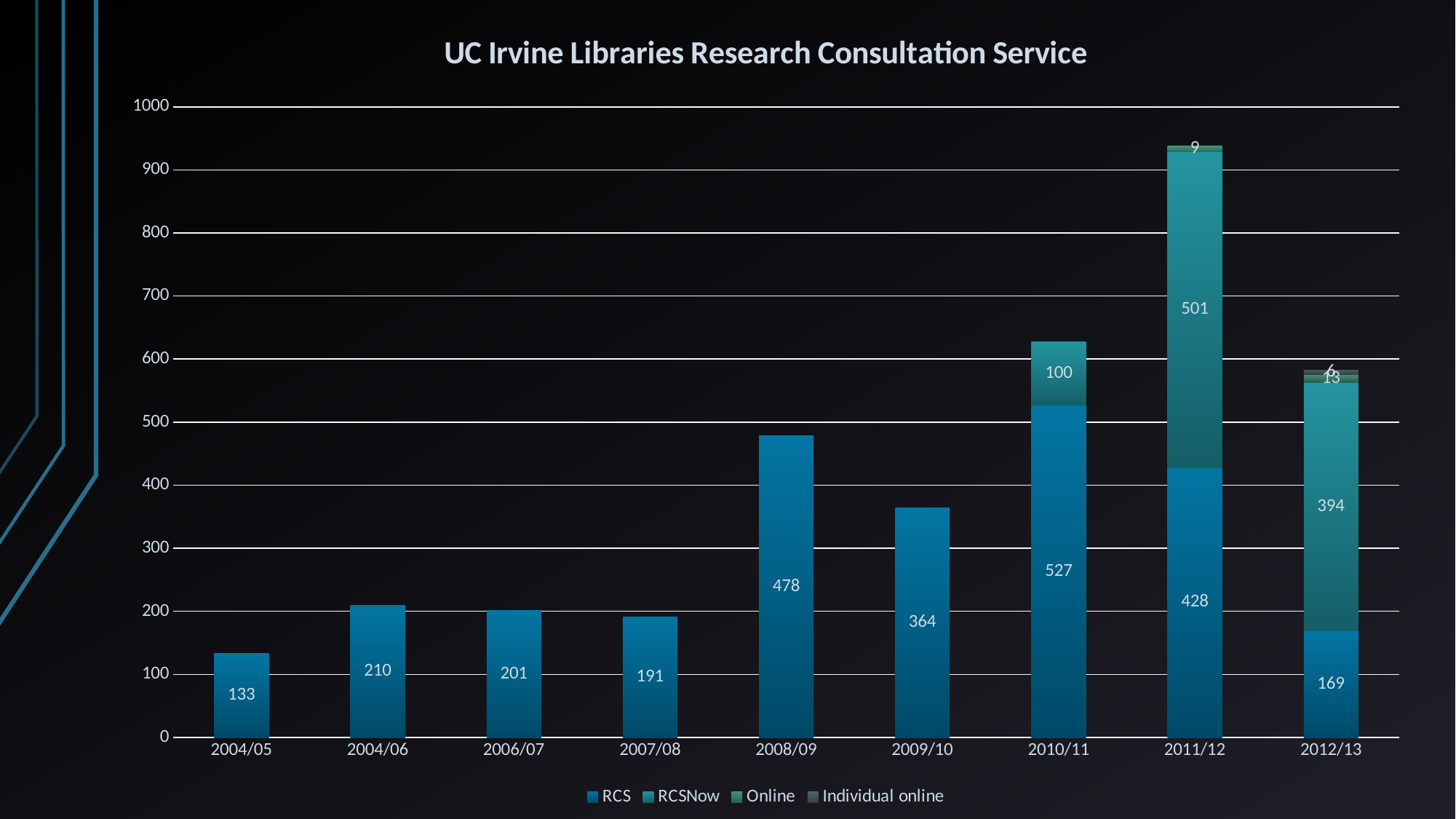
Which year has the highest RCS value? 2010/11 What is the RCS value for 2008/09? 478 How many series does the legend list? 4 What is the title of the chart? UC Irvine Libraries Research Consultation Service What is the total of the stacked bar for 2011/12? 938 How many years are shown on the x axis? 9 What kind of chart is shown on the slide? Stacked bar chart What is the difference between the RCS values for 2008/09 and 2009/10? 114 Which has the larger RCS value, 2004/06 or 2006/07? 2004/06 What is the RCSNow value for 2011/12? 501 What is the RCS value for 2012/13? 169 Which year has the lowest RCS value? 2004/05